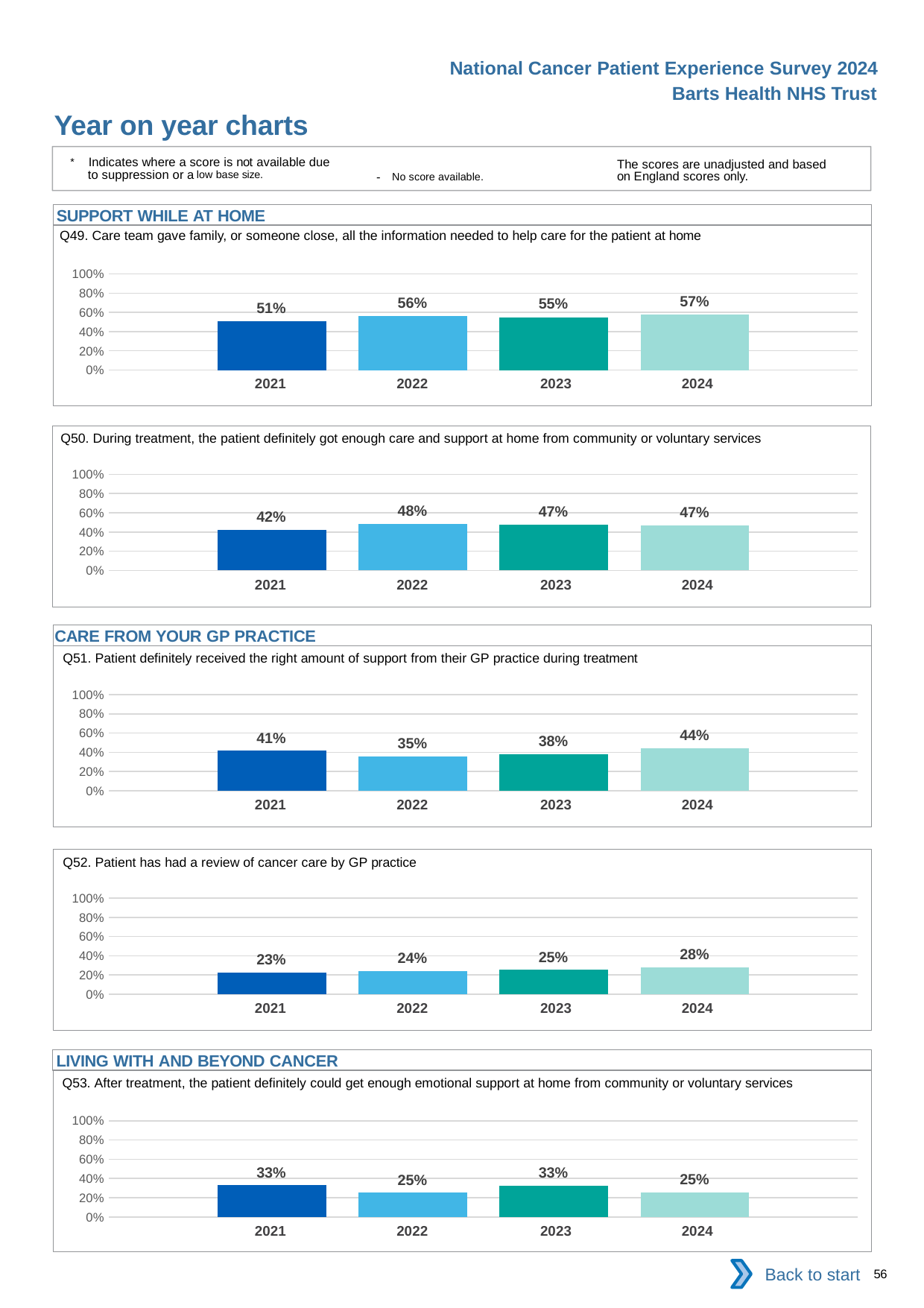
In the Q51 chart, what is the difference between the 2024 and 2022 values? 9 percentage points In the Q49 chart, is the value for 2022 larger or smaller than the value for 2023? larger In the Q53 chart, is the value for 2021 greater or less than 40%? less How many years are shown in the Q50 chart? 4 In the Q50 chart, what is the difference between the 2022 and 2021 values? 6 percentage points In the Q52 chart, which year has the highest value? 2024 In the Q49 chart, what is the value for 2024? 57% In the Q53 chart, what is the value for 2022? 25% In the Q52 chart, do the values rise or fall from 2021 to 2024? rise What type of chart is used for Q51? bar chart Which section heading appears above the Q53 chart? LIVING WITH AND BEYOND CANCER In the Q50 chart, which year has the lowest value? 2021